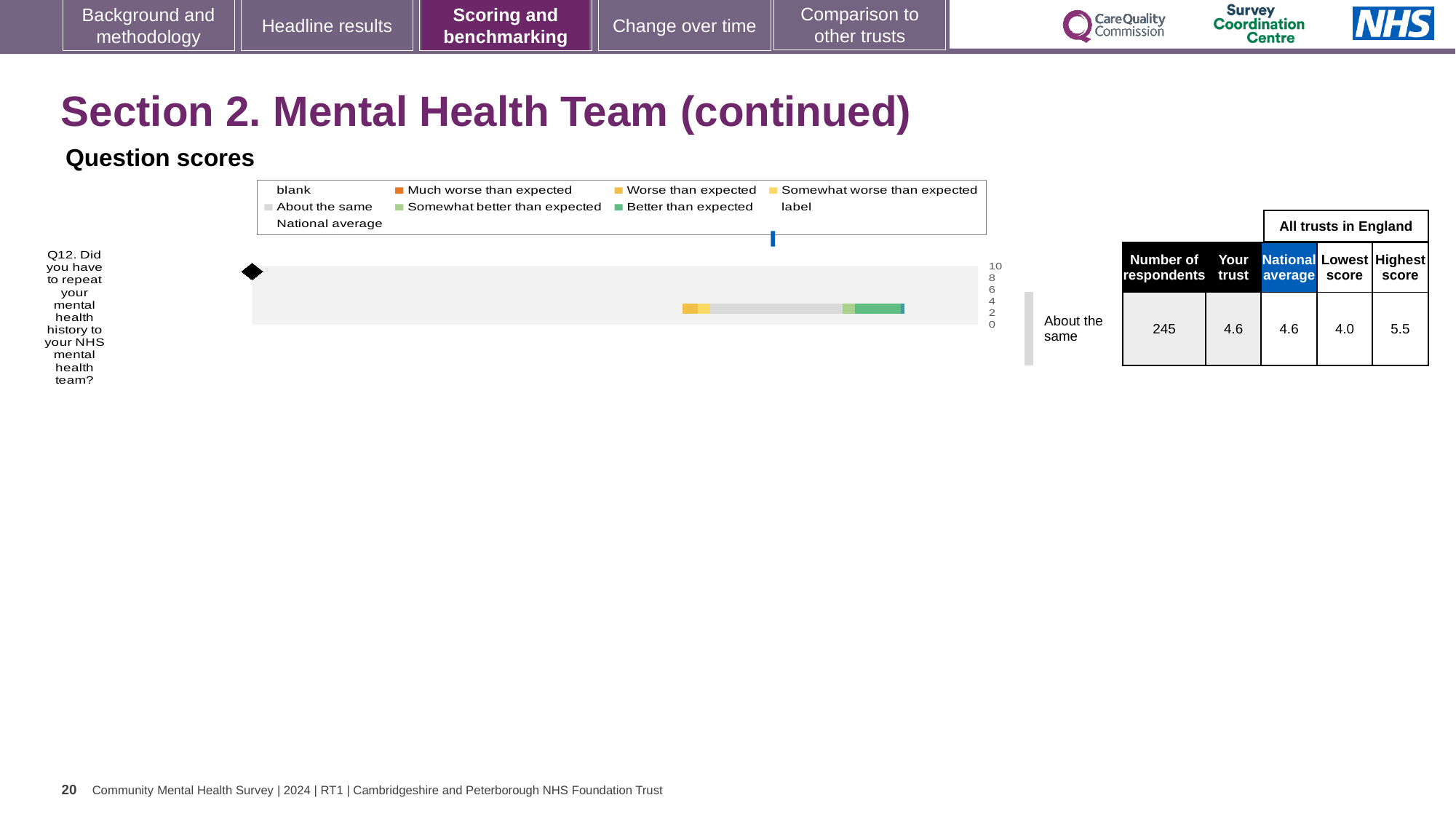
What benchmark category label is shown next to the bar for Q12? About the same In the table beside the chart, what is the national average score for Q12? 4.6 In the table beside the chart, what is the lowest score among all trusts in England for Q12? 4.0 What is the difference between the highest score and the lowest score for Q12 in the table beside the chart? 1.5 In the table beside the chart, what is the highest score among all trusts in England for Q12? 5.5 For Q12, is the 'Your trust' score or the lowest score among all trusts in England larger? Your trust What kind of chart is shown under 'Question scores'? bar chart In the table beside the chart, what is the number of respondents for Q12? 245 Which question is plotted in the Question scores chart? Q12. Did you have to repeat your mental health history to your NHS mental health team? In the table beside the chart, what is the 'Your trust' score for Q12? 4.6 What is the difference between the 'Your trust' score and the lowest score for Q12 in the table beside the chart? 0.6 How many questions are plotted in the Question scores chart? 1